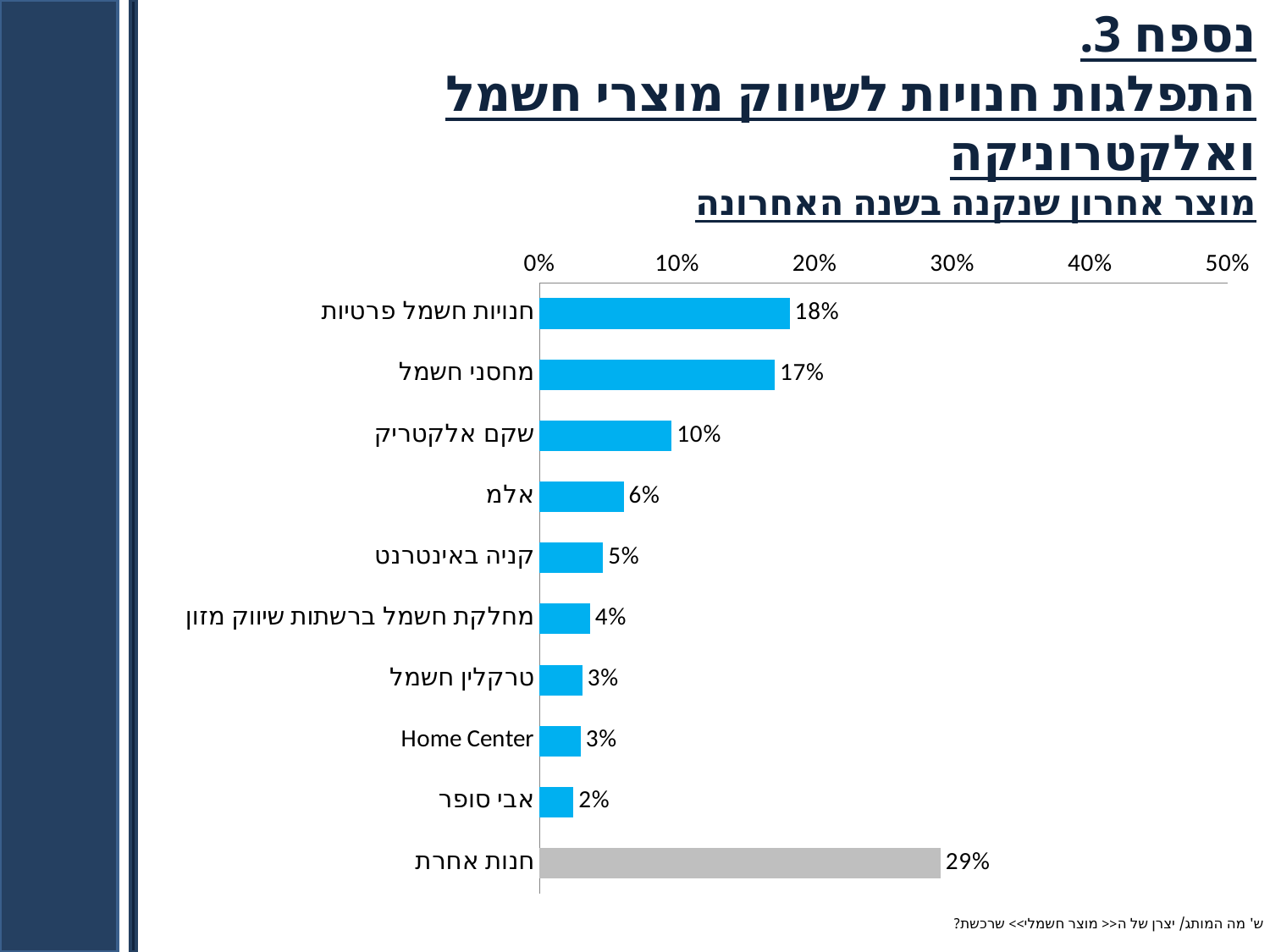
What is the difference between the values for חנויות חשמל פרטיות and מחסני חשמל? 1% What is the value for חנויות חשמל פרטיות? 18% Is the value for חנות אחרת greater or less than 20%? greater What kind of chart is shown on the slide? Bar chart What colour is the bar for חנות אחרת? Gray What is the value for מחסני חשמל? 17% Which category has the highest value? חנות אחרת How many categories are shown in the chart? 10 Which category has the lowest value? אבי סופר Which is larger, the value for שקם אלקטריק or the value for אלם? שקם אלקטריק What is the value for חנות אחרת? 29% What is the value for Home Center? 3%